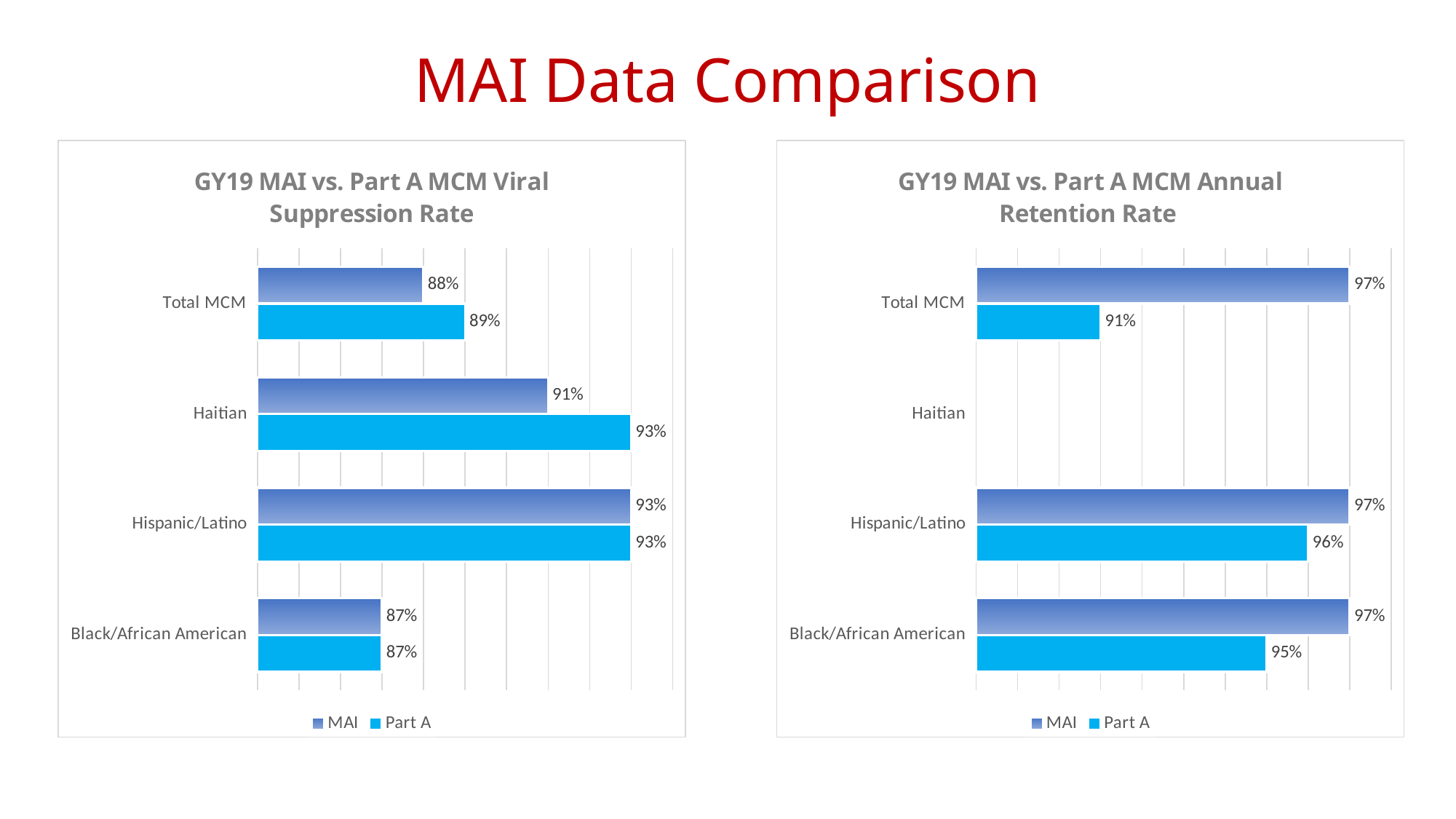
How many series does the legend list in the GY19 MAI vs. Part A MCM Viral Suppression Rate chart? 2 In the GY19 MAI vs. Part A MCM Annual Retention Rate chart, what is the difference between the MAI and Part A values for Total MCM? 6% In the GY19 MAI vs. Part A MCM Viral Suppression Rate chart, which category has the lowest Part A value? Black/African American In the GY19 MAI vs. Part A MCM Annual Retention Rate chart, which is larger for Hispanic/Latino, the MAI value or the Part A value? MAI In the GY19 MAI vs. Part A MCM Annual Retention Rate chart, which category has no bars plotted? Haitian In the GY19 MAI vs. Part A MCM Annual Retention Rate chart, what is the Part A value for Black/African American? 95% In the GY19 MAI vs. Part A MCM Viral Suppression Rate chart, what is the Part A value for Total MCM? 89% What kind of chart is the GY19 MAI vs. Part A MCM Annual Retention Rate chart? Bar chart In the GY19 MAI vs. Part A MCM Annual Retention Rate chart, which category has the lowest Part A value? Total MCM In the GY19 MAI vs. Part A MCM Annual Retention Rate chart, what is the MAI value for Total MCM? 97% In the GY19 MAI vs. Part A MCM Viral Suppression Rate chart, what is the MAI value for Haitian? 91% In the GY19 MAI vs. Part A MCM Viral Suppression Rate chart, what is the difference between the Part A and MAI values for Haitian? 2%